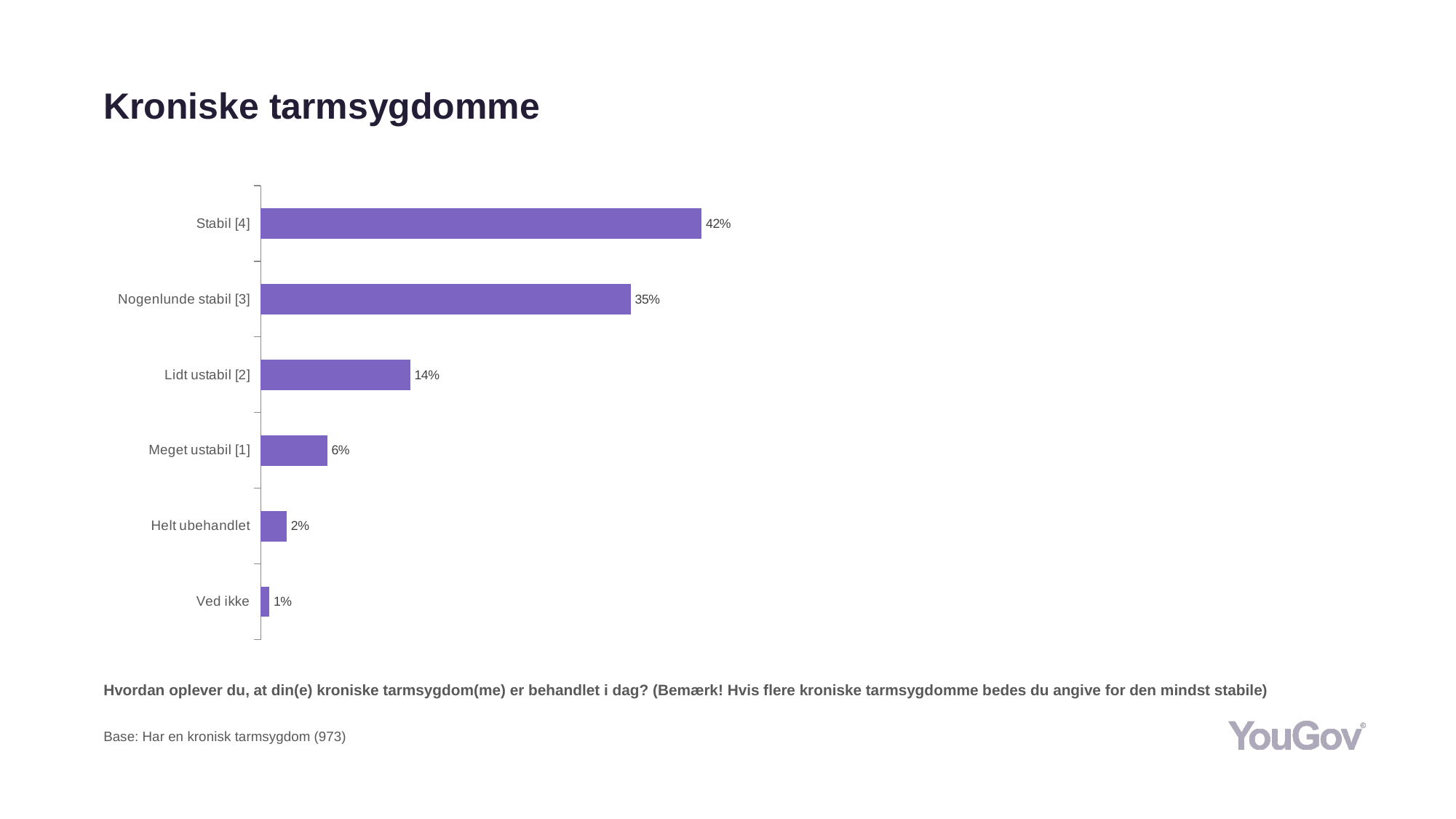
What is the value for Lidt ustabil [2]? 14% What is the value for Nogenlunde stabil [3]? 35% Which category has the lowest value? Ved ikke How many categories are shown in the chart? 6 Which category has the highest value? Stabil [4] Which is larger, the value for Meget ustabil [1] or the value for Helt ubehandlet? Meget ustabil [1] What kind of chart is shown on the slide? Bar chart What is the value for Helt ubehandlet? 2% What is the difference between the values for Lidt ustabil [2] and Meget ustabil [1]? 8% What is the value for Stabil [4]? 42% What is the difference between the values for Stabil [4] and Nogenlunde stabil [3]? 7% What is the title of the slide? Kroniske tarmsygdomme